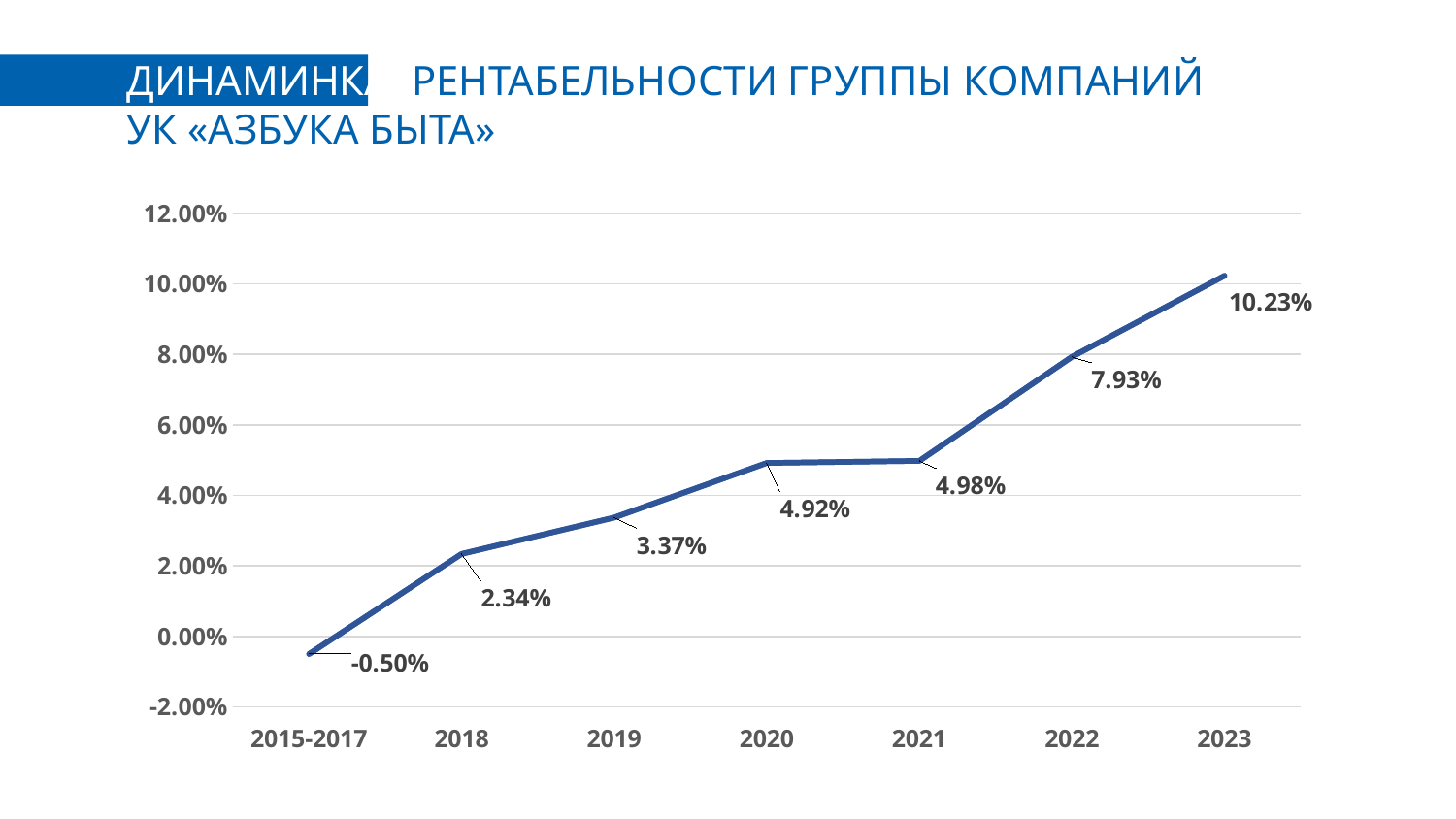
What is the value for 2020? 4.92% What kind of chart is shown on the slide? line chart Which period has the lowest profitability value? 2015-2017 What is the value shown for the 2015-2017 period? -0.50% What is the difference between the values for 2023 and 2022? 2.30% Which year has the highest profitability value? 2023 How many data points are plotted on the chart? 7 What is the profitability value for 2023? 10.23% What is the difference between the values for 2018 and 2015-2017? 2.84% What is the value for 2022? 7.93% Is the value for 2021 greater or less than 6.00%? less Which is larger, the value for 2019 or the value for 2022? 2022